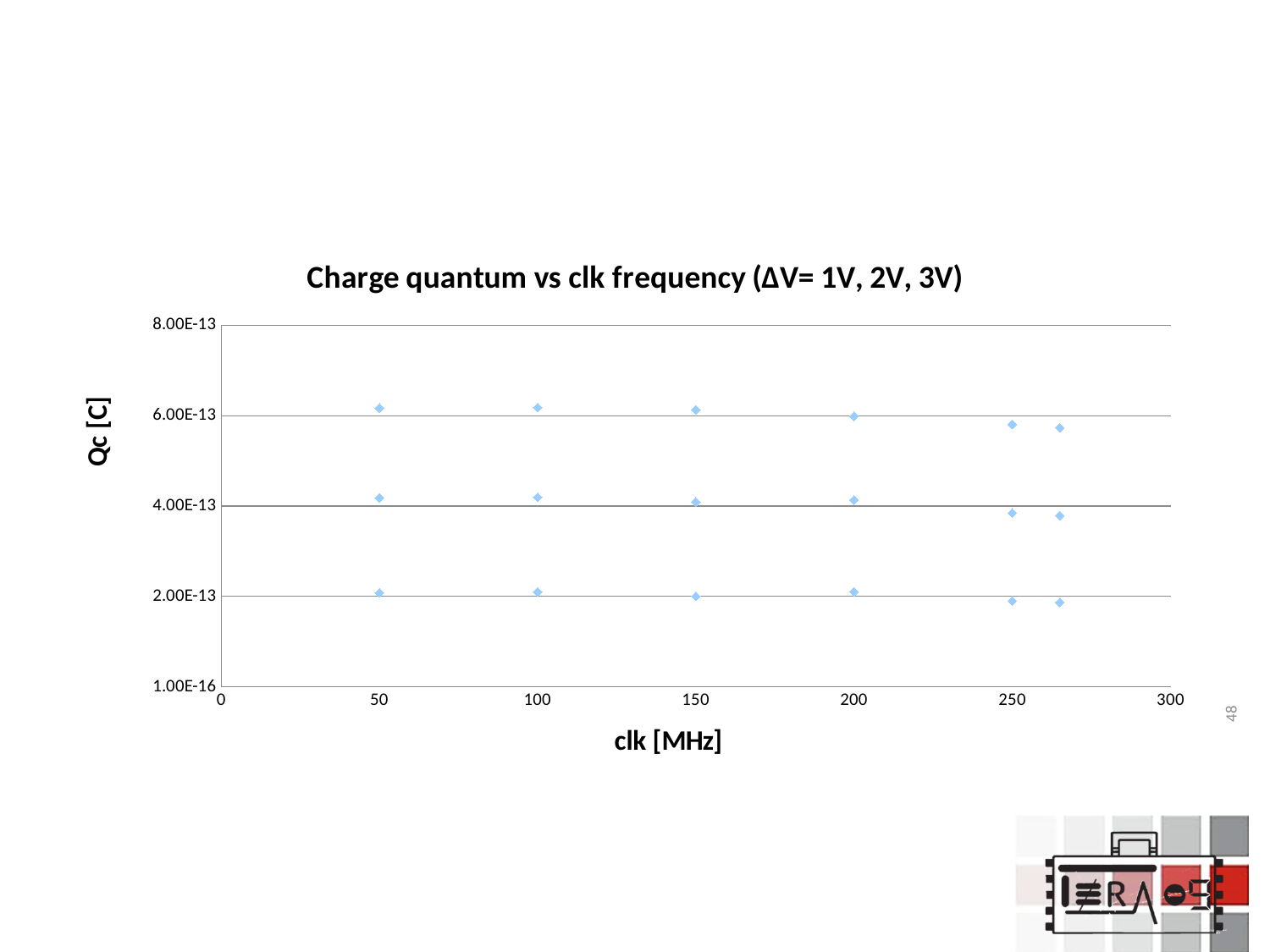
How many horizontal groups (rows) of points are plotted on the chart? 3 Is the value of the highest point at 250 MHz greater or less than 6.00E-13? less How many distinct clk frequency values have points plotted on the chart? 6 Is the value of the highest point at 50 MHz greater or less than 6.00E-13? greater Is the value of the lowest point at 250 MHz greater or less than 2.00E-13? less What kind of chart is shown on the slide? scatter chart What is the title of the chart? Charge quantum vs clk frequency (ΔV= 1V, 2V, 3V) What is the label of the x axis of the chart? clk [MHz] In the top row of points, which has the larger value: the point at 50 MHz or the point at 265 MHz? 50 MHz Do the values in the top row of points rise or fall as clk frequency increases from 50 MHz to 265 MHz? fall